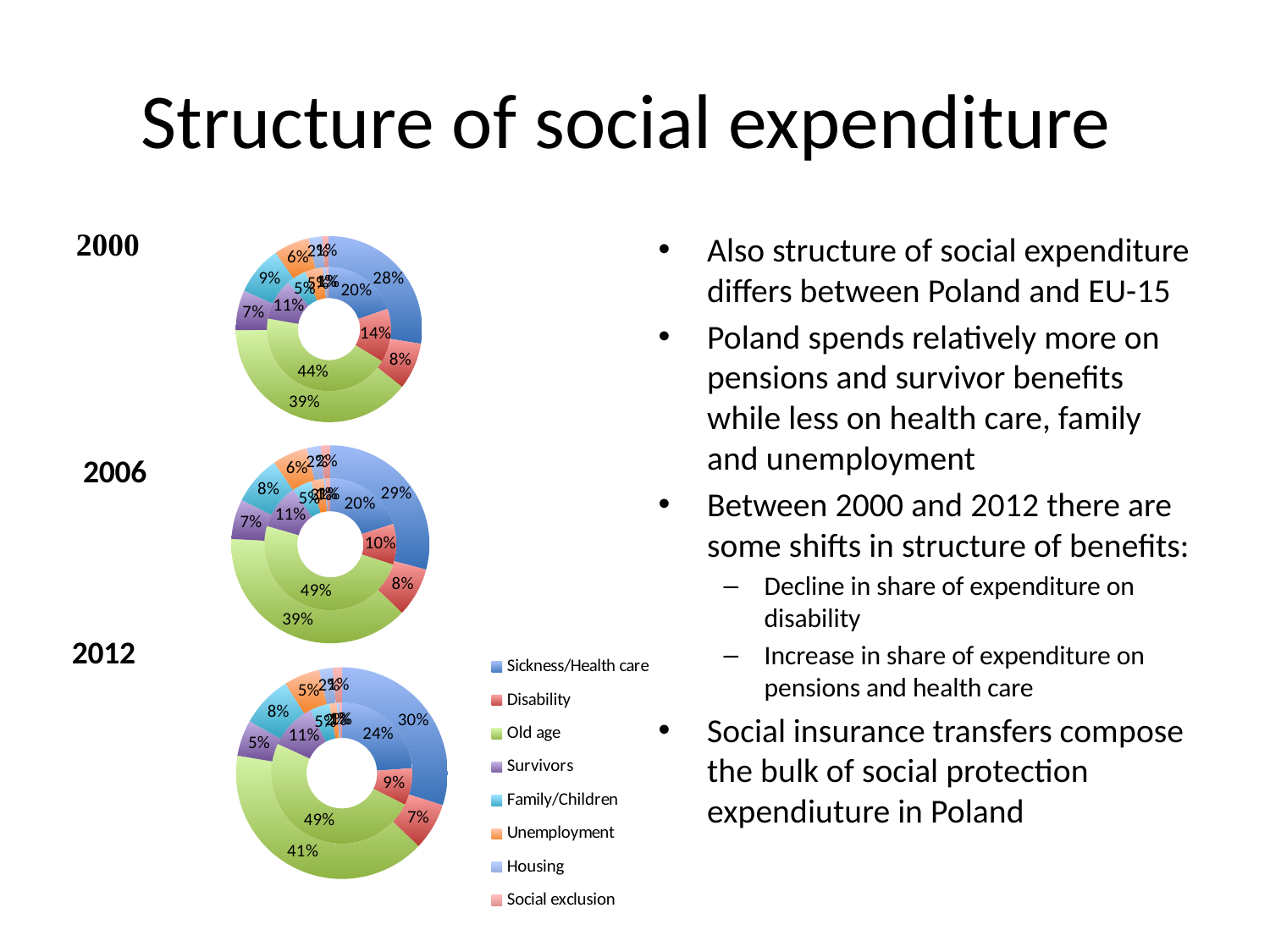
In the 2000 chart, which is larger in the inner ring: Disability (14%) or Survivors (11%)? Disability How many charts are shown on the slide? 3 Across the 2000, 2006 and 2012 charts, does the outer-ring share of Sickness/Health care rise or fall? Rise How many categories does the legend list? 8 In the 2000 chart, what is the share of Old age in the outer ring? 39% What kind of chart is used to show the structure of social expenditure for each year? Doughnut (pie) chart In the 2012 chart, what is the difference between the Old age share in the inner ring (49%) and in the outer ring (41%)? 8 percentage points Which legend entry is shown in green? Old age In the 2000 chart, what is the share of Sickness/Health care in the outer ring? 28% In the 2000 chart, which category has the largest share in the inner ring? Old age In the 2006 chart, what is the share of Old age in the inner ring? 49% In the 2012 chart, what is the share of Sickness/Health care in the outer ring? 30%